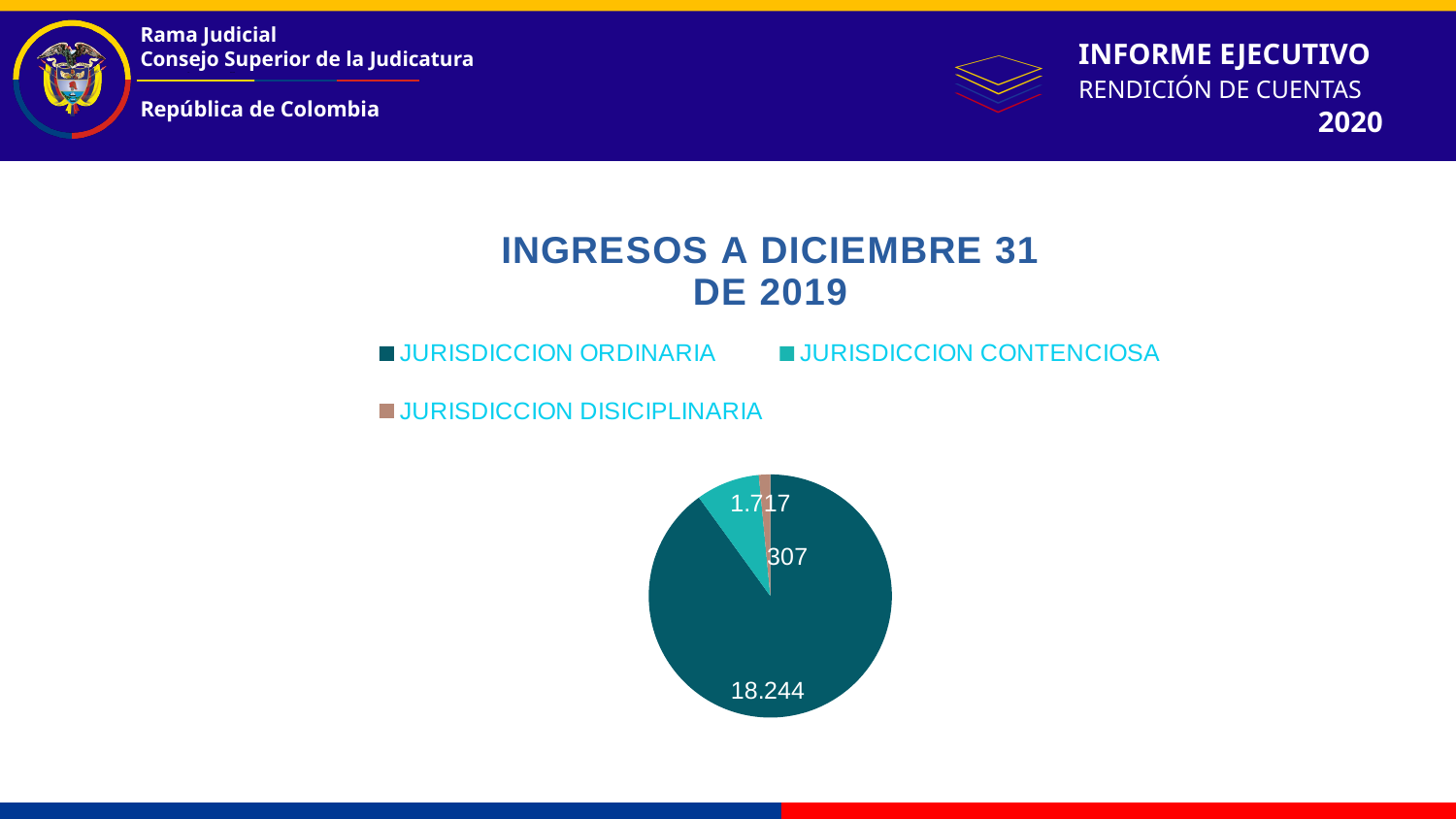
Which is larger, the value for JURISDICCION CONTENCIOSA or JURISDICCION DISCIPLINARIA? JURISDICCION CONTENCIOSA How many entries does the legend list? 3 What is the value for JURISDICCION CONTENCIOSA? 1.717 How many slices does the pie chart have? 3 What type of chart is shown on the slide? Pie chart What is the value for JURISDICCION ORDINARIA? 18.244 What is the difference between the values for JURISDICCION ORDINARIA and JURISDICCION CONTENCIOSA? 16.527 Which jurisdiction has the smallest slice of the pie? JURISDICCION DISCIPLINARIA Which jurisdiction has the largest slice of the pie? JURISDICCION ORDINARIA What is the title of the chart? INGRESOS A DICIEMBRE 31 DE 2019 What is the value for JURISDICCION DISCIPLINARIA? 307